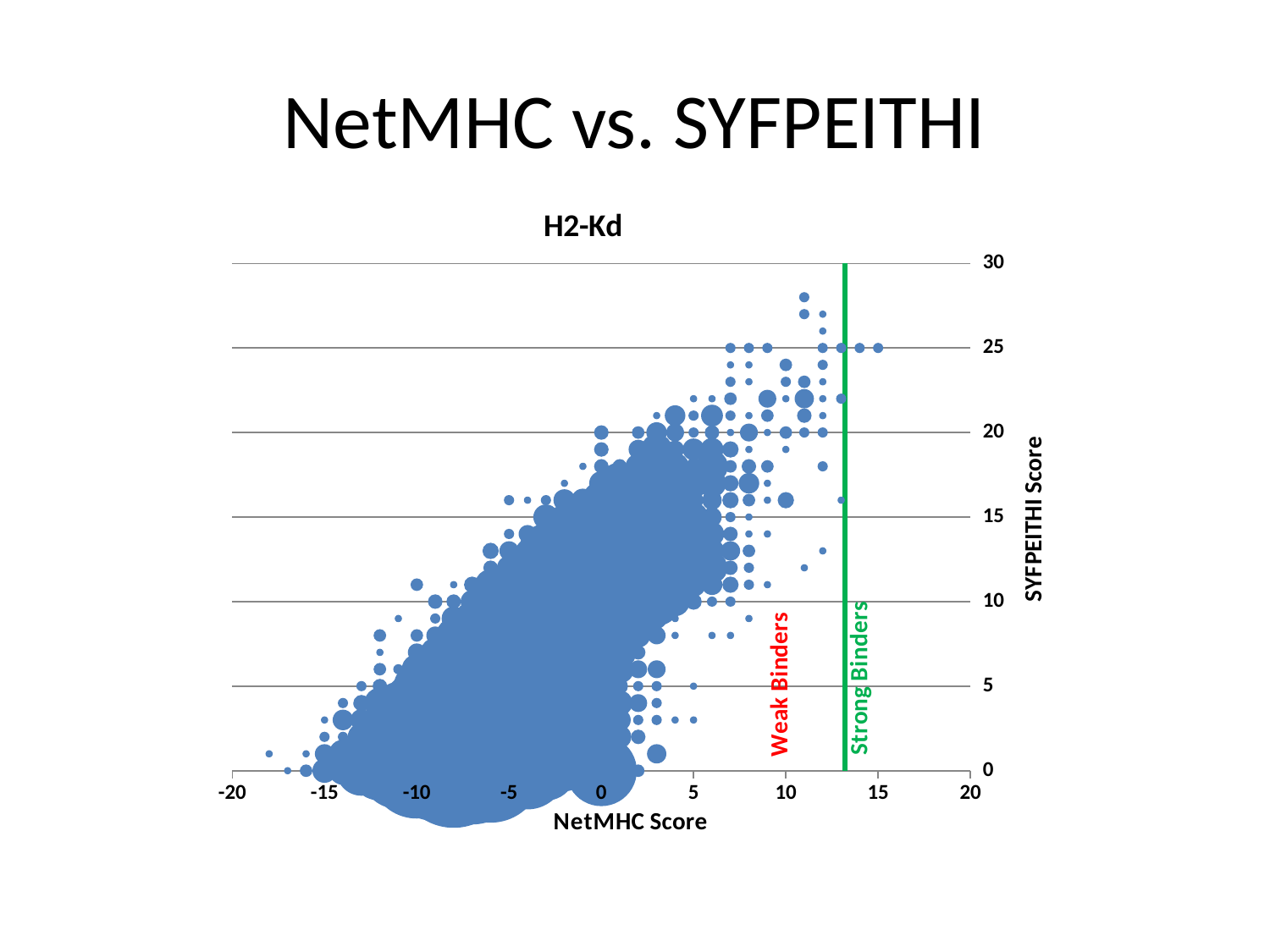
Is the highest SYFPEITHI Score plotted greater or less than 30? less Is the highest SYFPEITHI Score plotted greater or less than 25? greater What label is written in green text next to the vertical green line? Strong Binders Is the NetMHC Score at which the green vertical line is drawn greater or less than 15? less What SYFPEITHI Score does the rightmost bubble (at NetMHC Score 15) have? 25 As NetMHC Score increases along the x axis, do the SYFPEITHI Scores generally rise or fall? rise What kind of chart is shown on the slide? bubble chart What is the title of the chart? H2-Kd